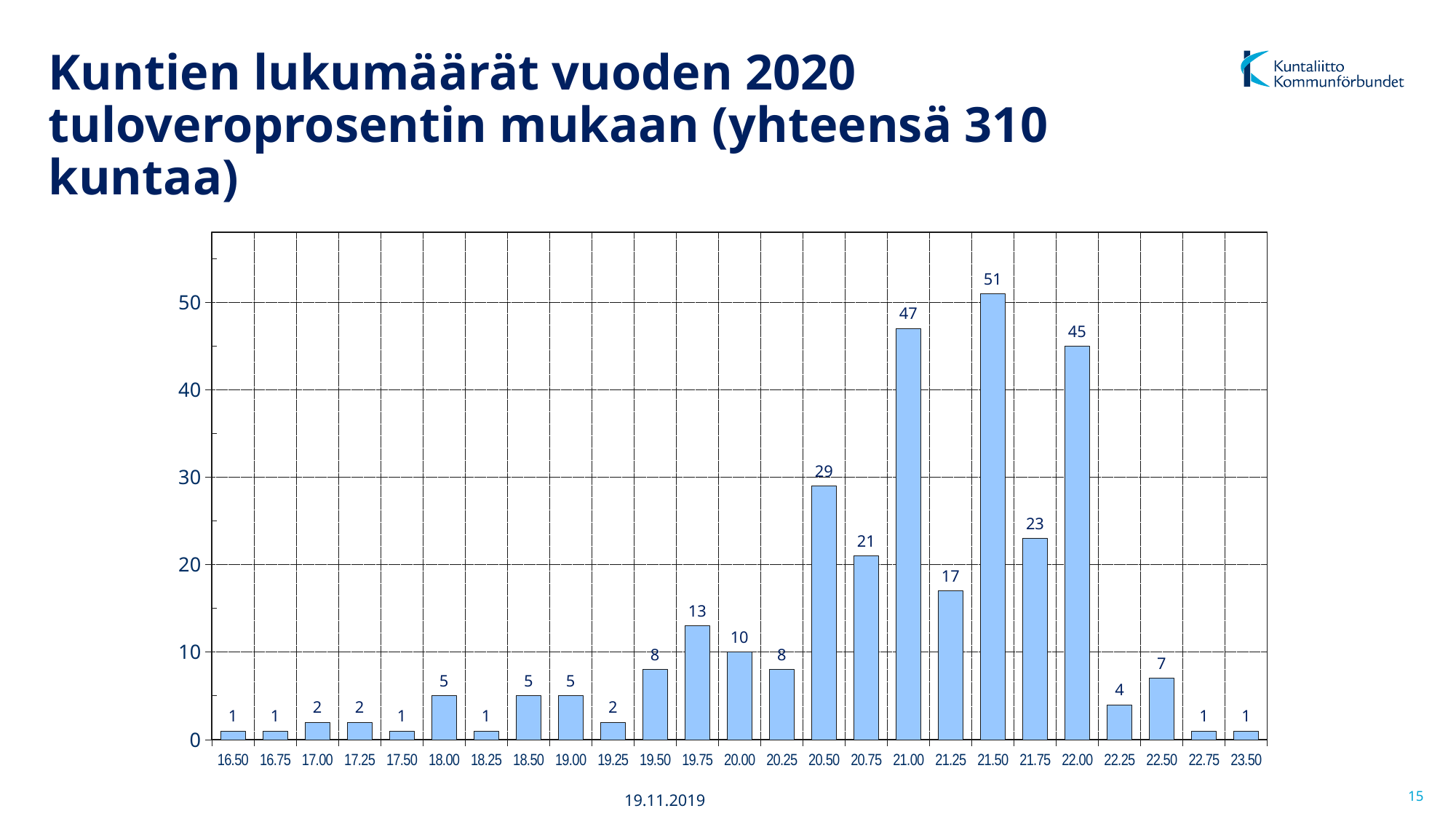
Which has a larger value, 20.50 or 21.75? 20.50 How many tax rate categories are shown on the x axis? 25 Is the value for 21.00 greater or less than 40? greater How many municipalities have a tax rate of 21.50? 51 What is the value shown for the 19.75 category? 13 What is the difference between the values for 20.50 and 20.75? 8 What is the value shown for the 22.50 category? 7 What is the difference between the values for 21.50 and 21.00? 4 What is the title of the slide? Kuntien lukumäärät vuoden 2020 tuloveroprosentin mukaan (yhteensä 310 kuntaa) Which tax rate category has the highest number of municipalities? 21.50 What kind of chart is shown on the slide? Bar chart What is the value shown for the 20.50 category? 29